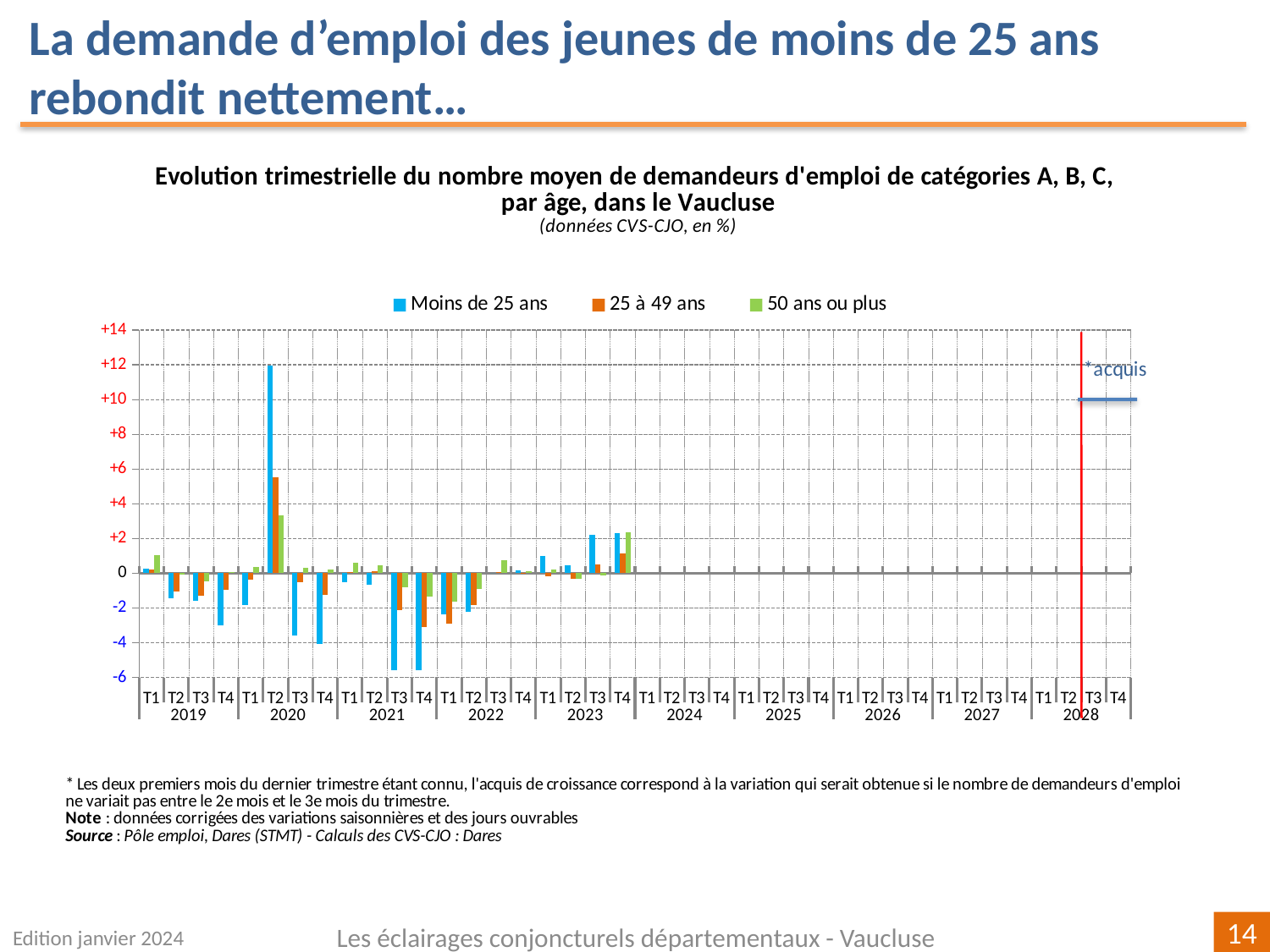
In T2 2020, which is larger: the value for '25 à 49 ans' or the value for '50 ans ou plus'? 25 à 49 ans What kind of chart is shown on the slide? bar chart Is the value for '25 à 49 ans' in T2 2020 greater or less than +4? greater Is the value for '50 ans ou plus' in T2 2020 greater or less than +2? greater How many series does the legend list? 3 Is the value for 'Moins de 25 ans' in T4 2019 greater or less than -2? less In which quarter does the 'Moins de 25 ans' series reach its highest value? T2 2020 What colour represents the 'Moins de 25 ans' series? blue Which series are listed in the legend? Moins de 25 ans, 25 à 49 ans, 50 ans ou plus In T2 2020, which is larger: the value for 'Moins de 25 ans' or the value for '25 à 49 ans'? Moins de 25 ans